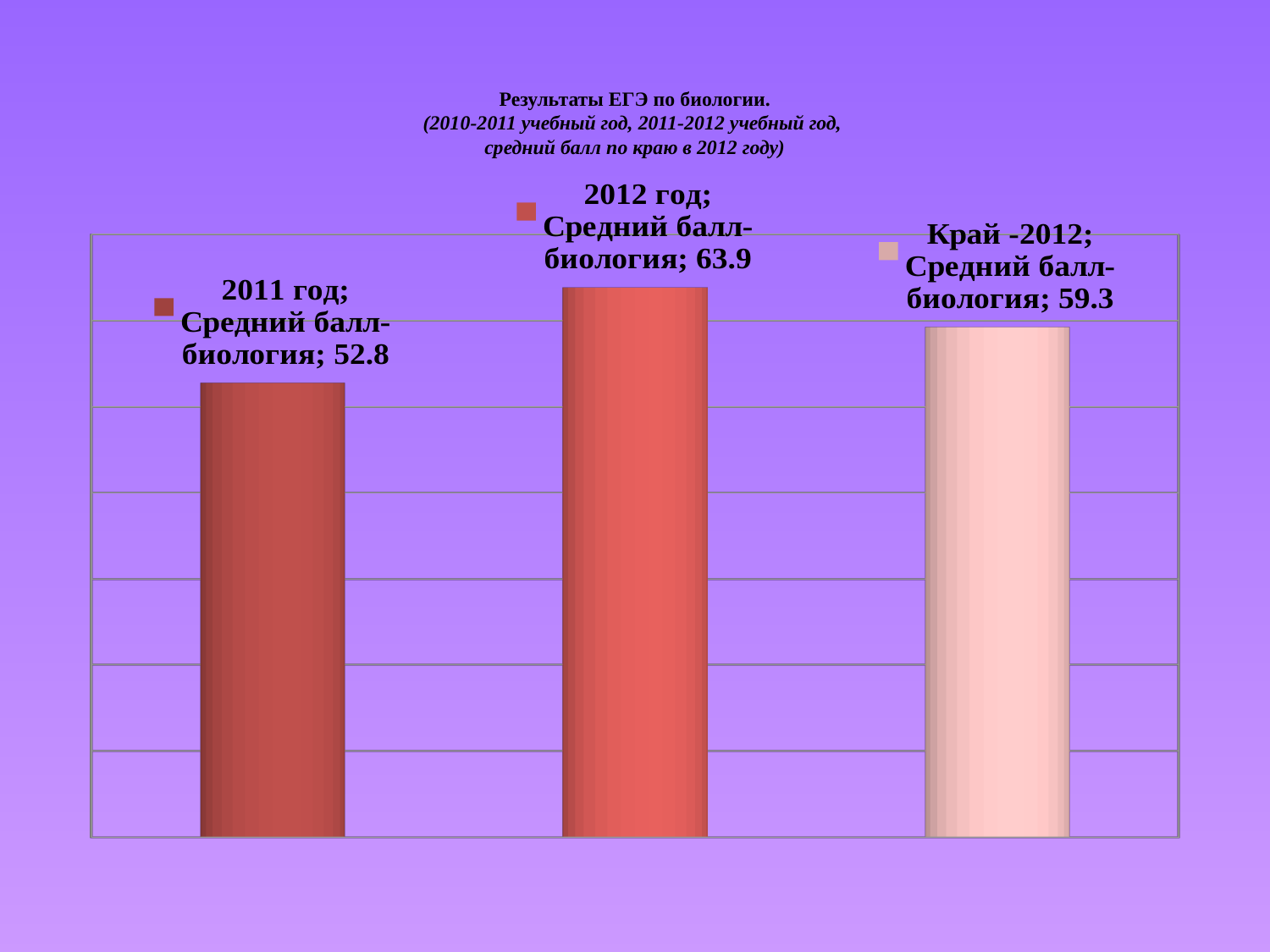
Which category has the highest average biology score? 2012 год What is the title of the chart? Результаты ЕГЭ по биологии. Which is larger: the average biology score for Край -2012 or for 2011 год? Край -2012 What kind of chart is shown on the slide? Bar chart What is the difference between the average biology score for 2012 год and for 2011 год? 11.1 What is the average biology score (Средний балл-биология) for 2011 год? 52.8 How many bars are plotted on the chart? 3 Which category has the lowest average biology score? 2011 год What is the difference between the average biology score for 2012 год and for Край -2012? 4.6 Which bar is the lightest in colour? Край -2012 What is the average biology score (Средний балл-биология) for Край -2012? 59.3 What is the average biology score (Средний балл-биология) for 2012 год? 63.9